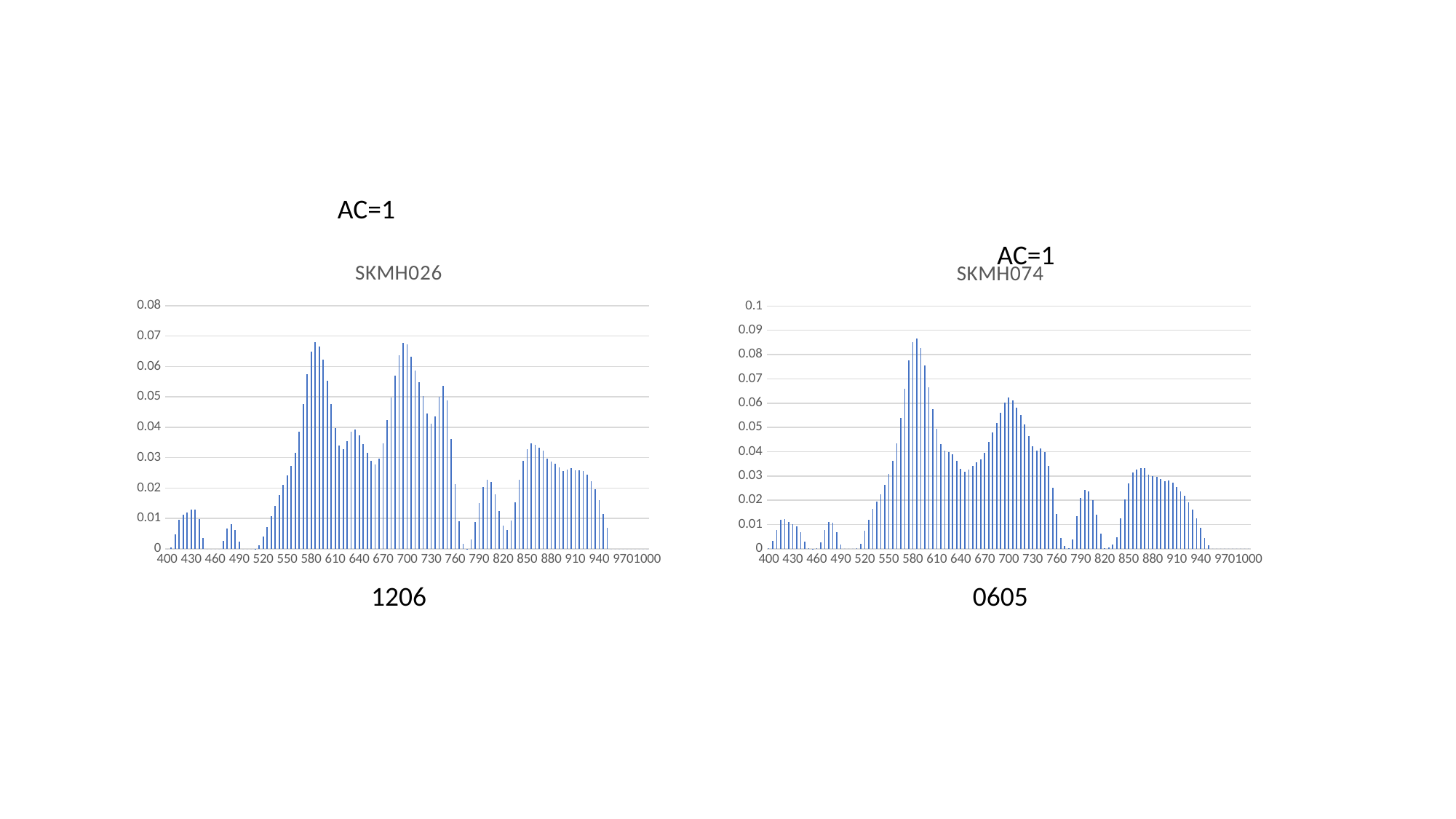
What is the title of the left chart? SKMH026 What is the title of the right chart? SKMH074 In the left chart SKMH026, is the value at 850 greater or less than 0.04? less In the left chart SKMH026, is the value at 580 greater or less than 0.06? greater In the right chart SKMH074, is the value at 700 greater or less than 0.05? greater What kind of chart is the left chart titled SKMH026? bar chart What kind of chart is the right chart titled SKMH074? bar chart In the right chart SKMH074, which is larger, the peak near 580 or the peak near 700? the peak near 580 In the right chart SKMH074, do the values rise or fall along the x axis from 850 to 940? fall